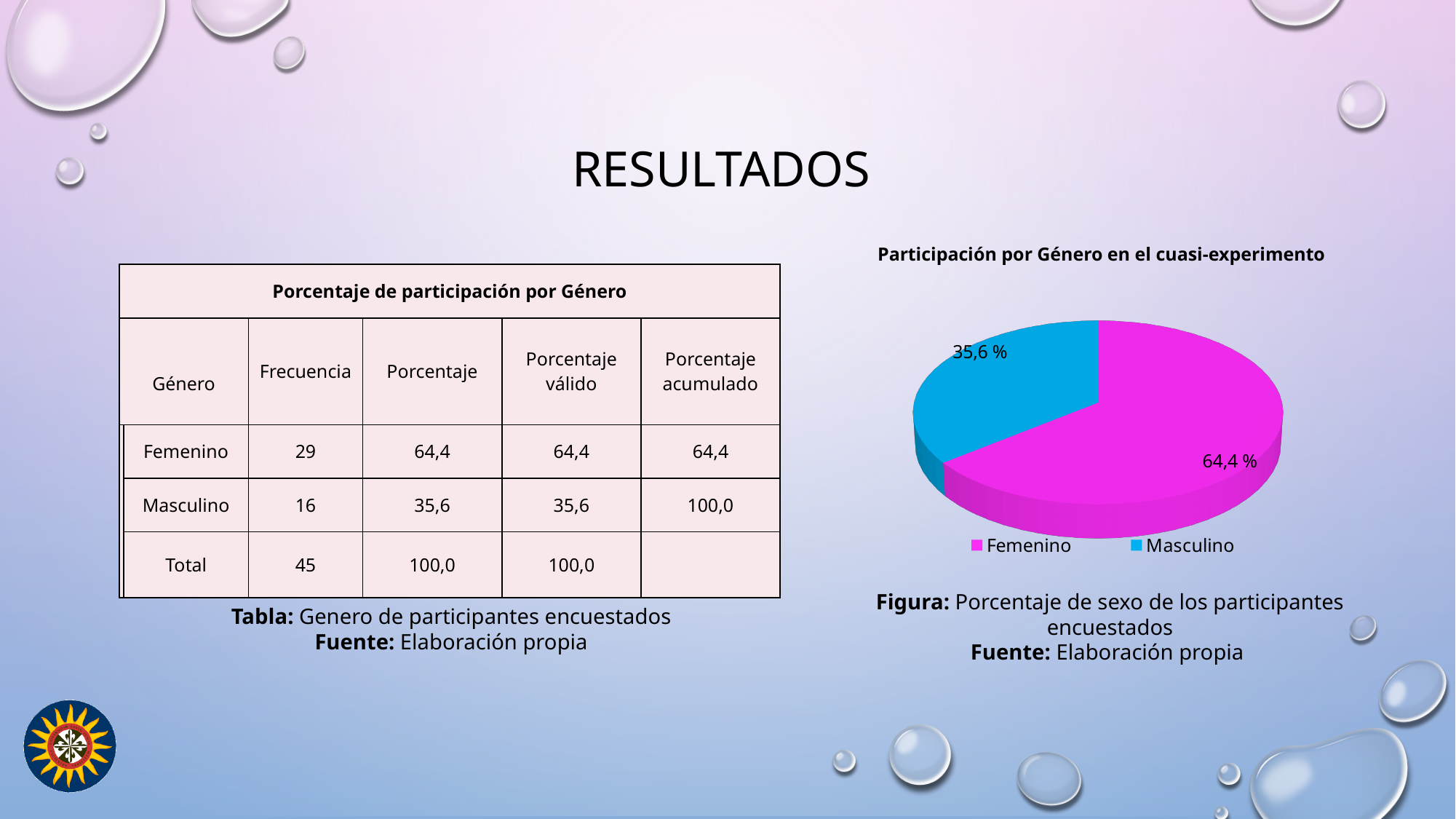
How many entries does the legend list? 2 Which category has the smallest slice of the pie? Masculino How many slices does the pie chart have? 2 What share of the pie does the Femenino slice represent? 64,4 % Which slice is larger, Femenino or Masculino? Femenino What percentage does the Masculino slice show? 35,6 % Which category has the largest slice of the pie? Femenino What is the difference in percentage points between the Femenino and Masculino slices? 28,8 What colour is the Masculino slice? blue What is the chart's title? Participación por Género en el cuasi-experimento What kind of chart is shown on the slide? pie chart What percentage does the Femenino slice show? 64,4 %